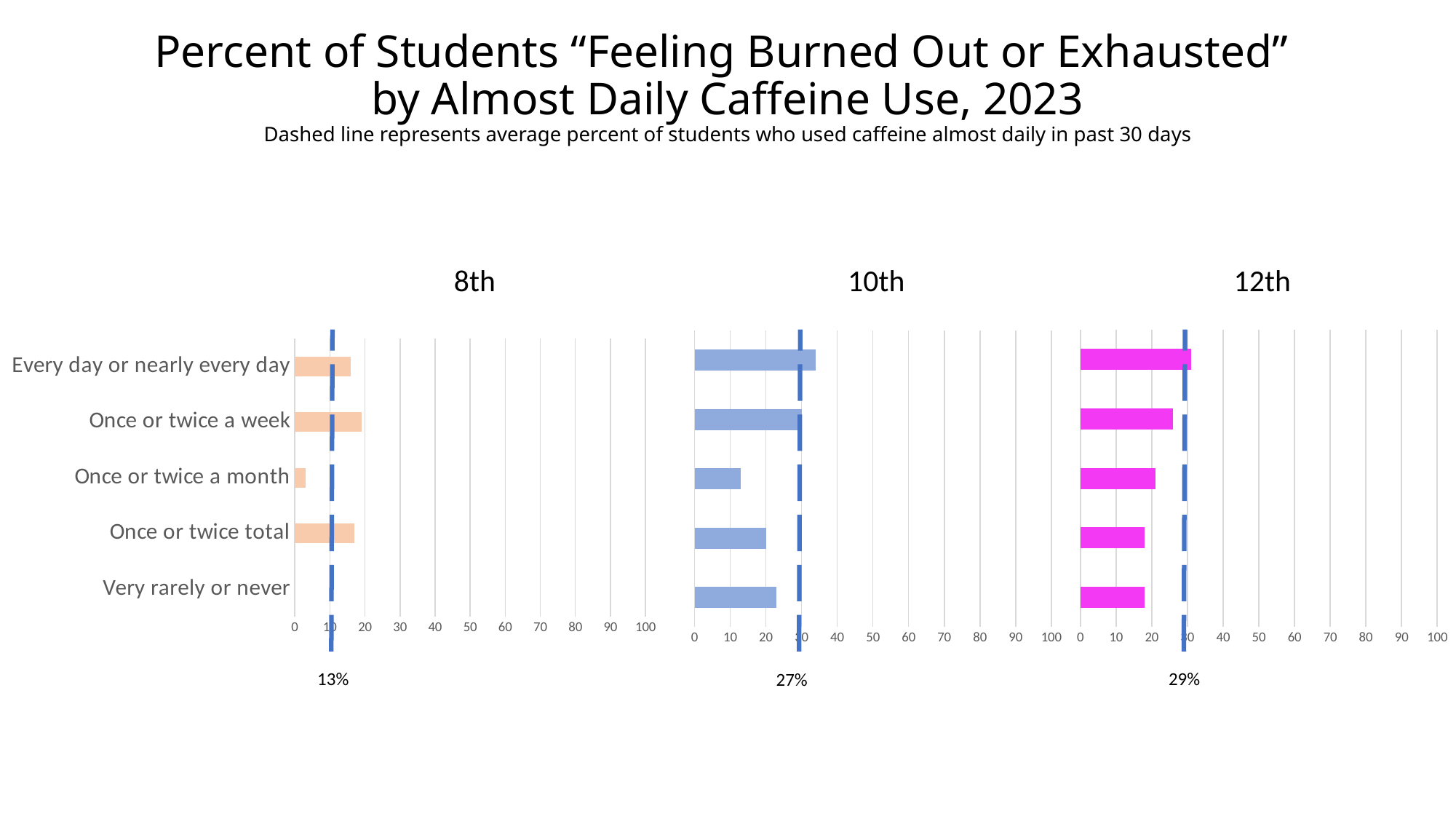
In the 12th grade chart, what value is labeled under the dashed line? 29% How many caffeine-use categories are listed on the y axis? 5 What kind of chart is used for each grade on this slide? Bar chart In the 12th grade chart, which category has the longest bar? Every day or nearly every day In the 10th grade chart, what value is labeled under the dashed line? 27% In the 8th grade chart, which is larger: the bar for 'Once or twice a week' or the bar for 'Once or twice a month'? Once or twice a week In the 12th grade chart, is the value for 'Once or twice a week' greater or less than 30? less In the 10th grade chart, is the value for 'Every day or nearly every day' greater or less than 30? greater In the 8th grade chart, what average percent of students used caffeine almost daily, as labeled under the dashed line? 13% In the 10th grade chart, which category has the shortest bar? Once or twice a month In the 10th grade chart, which category has the longest bar? Every day or nearly every day What is the difference between the dashed-line averages labeled for 12th grade and 8th grade? 16 percentage points